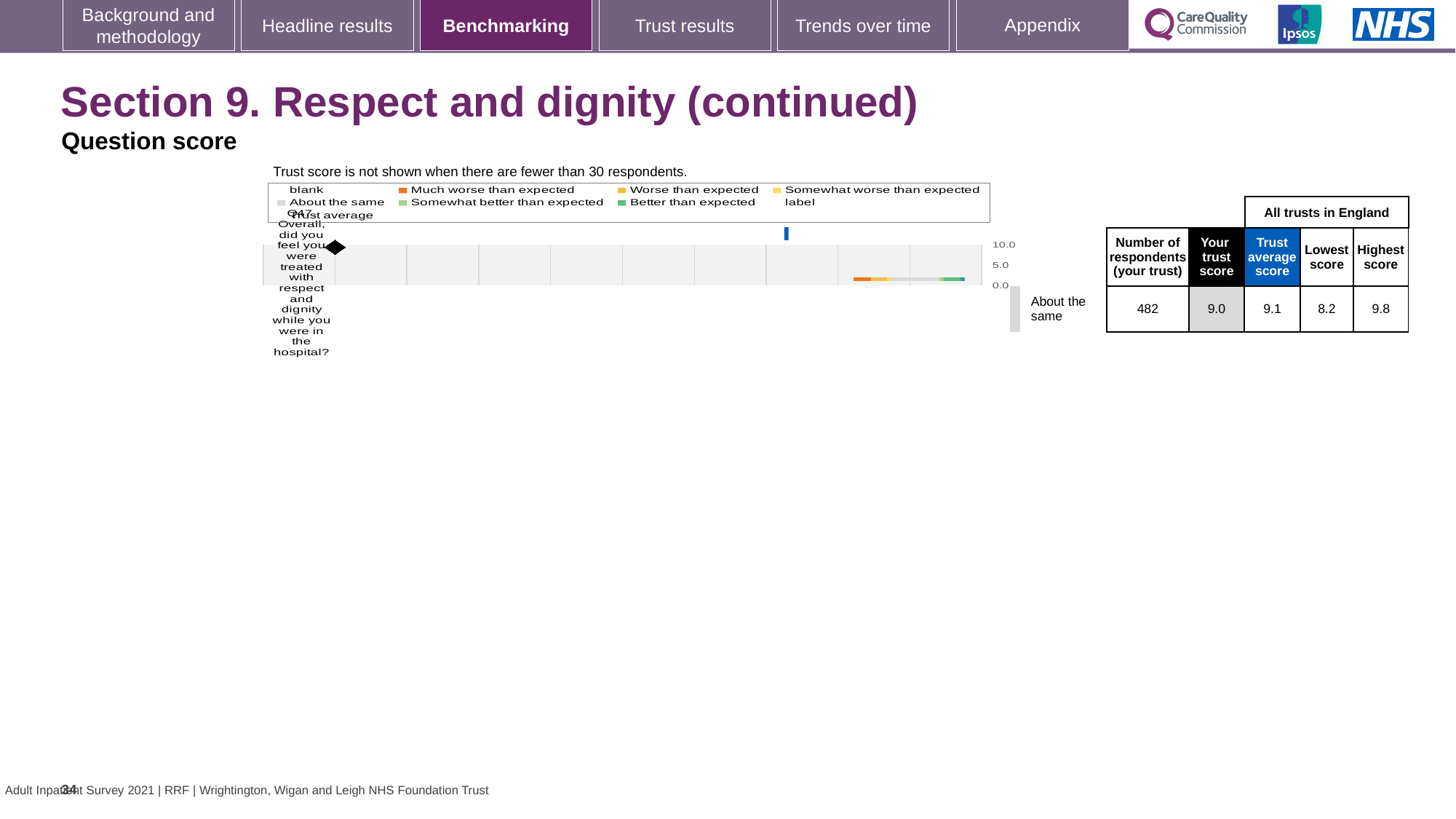
How many respondents from your trust answered Q47? 482 What is the lowest score for Q47 among all trusts in England? 8.2 Is the trust score for Q47 greater or less than 5.0? greater How many questions are plotted in the chart? 1 What is the difference between the highest score and the lowest score for Q47? 1.6 What is the highest score for Q47 among all trusts in England? 9.8 What kind of chart is shown on the slide for Q47? bar chart What is the highest value shown on the chart's score axis? 10.0 What colour does the legend use for 'Much worse than expected'? orange Which is larger for Q47: your trust score or the trust average score? Trust average score What is the trust average score for Q47 across all trusts in England? 9.1 What is the trust score for Q47 (Your trust score)? 9.0